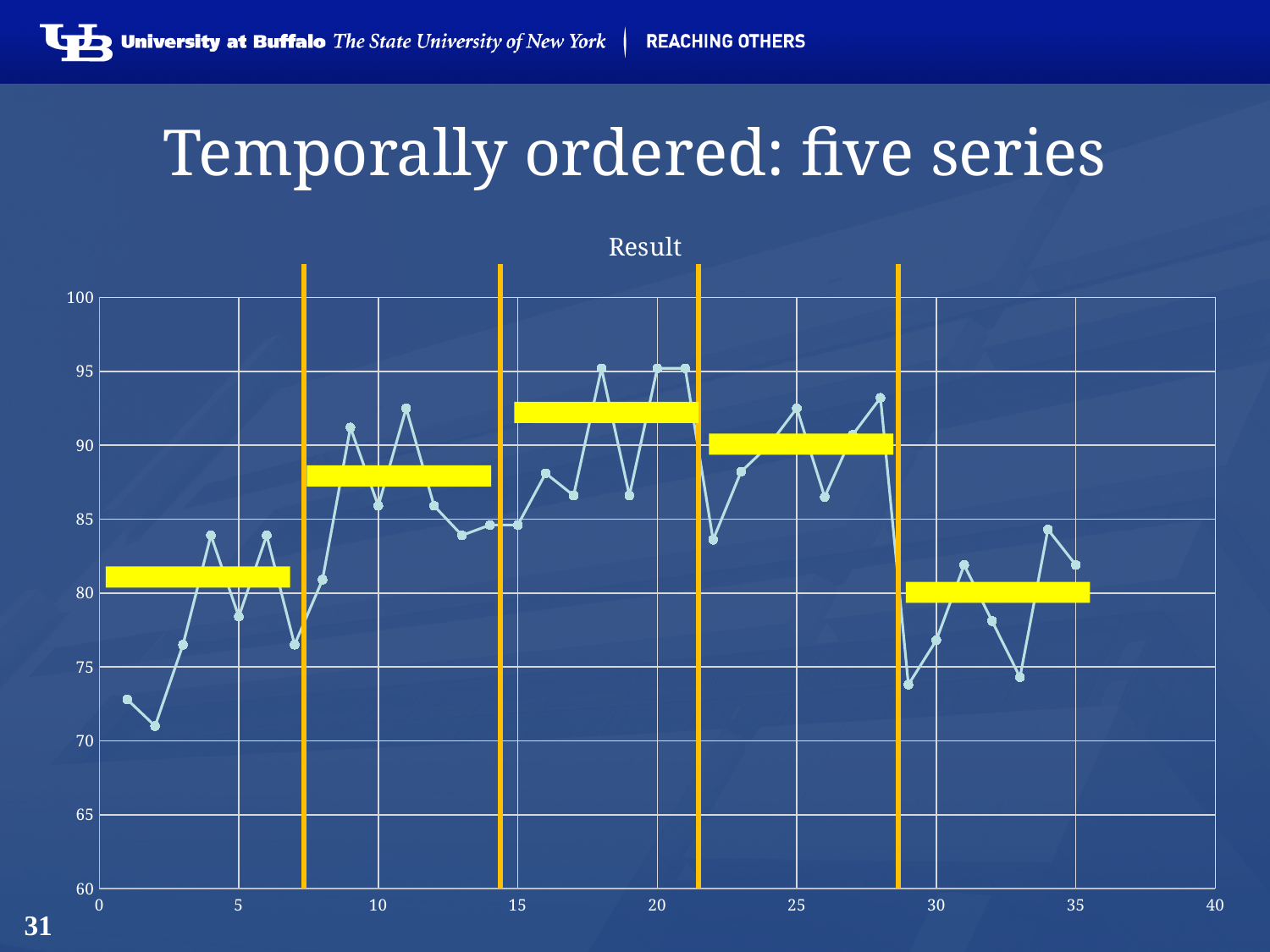
Is the value at x = 18 greater or less than 90? greater Is the value at x = 2 greater or less than 75? less Is the value at x = 11 greater or less than 90? greater How many vertical orange divider lines separate the series on the chart? 4 What is the title of the chart? Result Which has the larger value, the point at x = 2 or the point at x = 18? x = 18 What kind of chart is shown on the slide? line chart At which x value does the lowest point on the chart occur? 2 Does the line rise or fall between x = 1 and x = 2? fall